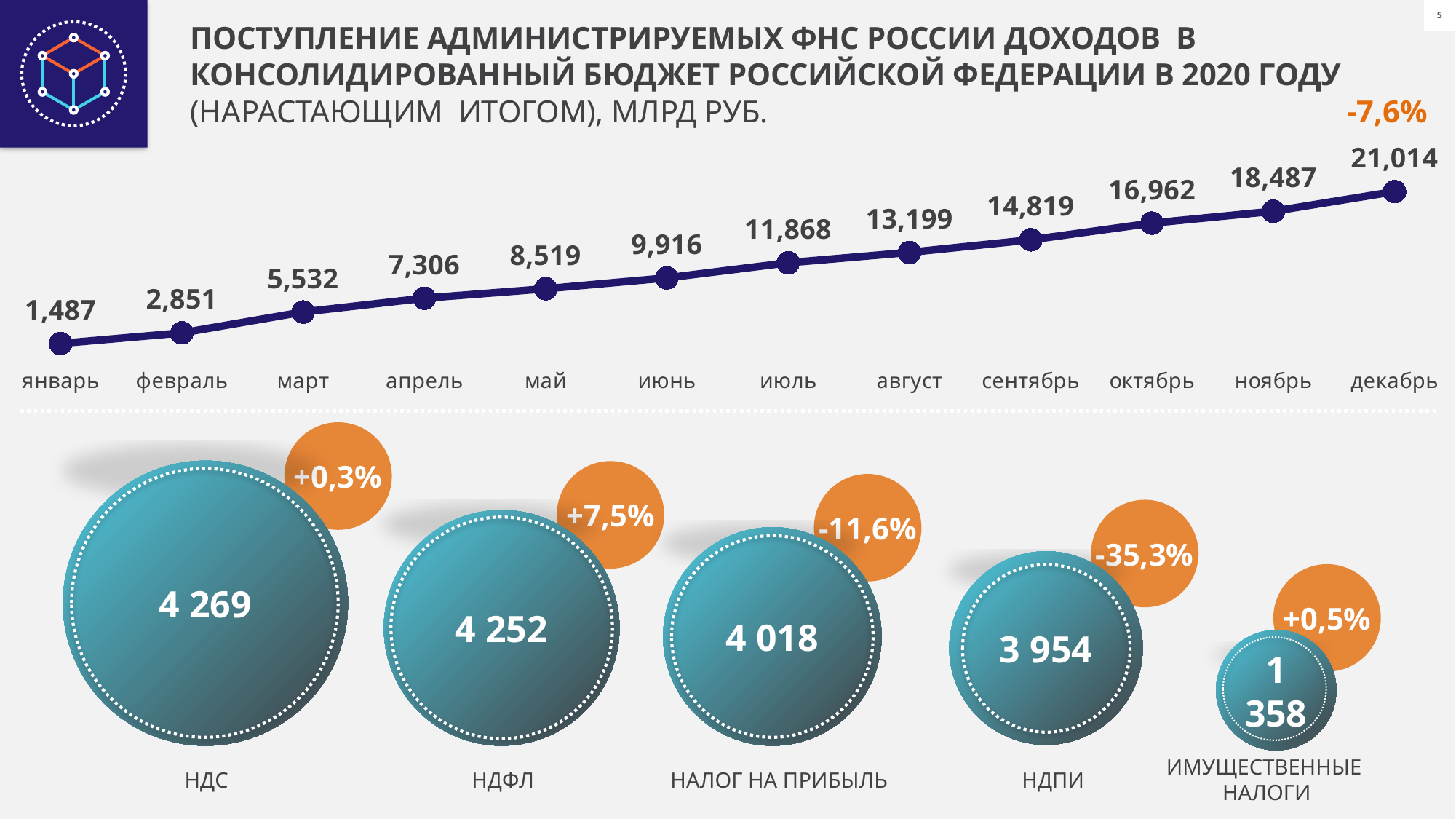
In the top line chart, what is the value for июль? 11,868 In the top line chart, which month has the lowest value? январь In the top line chart, what is the difference between the values for март and февраль? 2,681 In the top line chart, what is the value for декабрь? 21,014 In the bubble graphic at the bottom, what is the value shown for НДПИ? 3 954 In the top line chart, what is the difference between the values for декабрь and ноябрь? 2,527 In the bubble graphic at the bottom, which category has the largest value? НДС In the top line chart, which month has the highest value? декабрь What type of chart is the top chart on the slide? line chart In the top line chart, how many months are plotted? 12 In the top line chart, do the values rise or fall from январь to декабрь? rise In the top line chart, what is the value for январь? 1,487